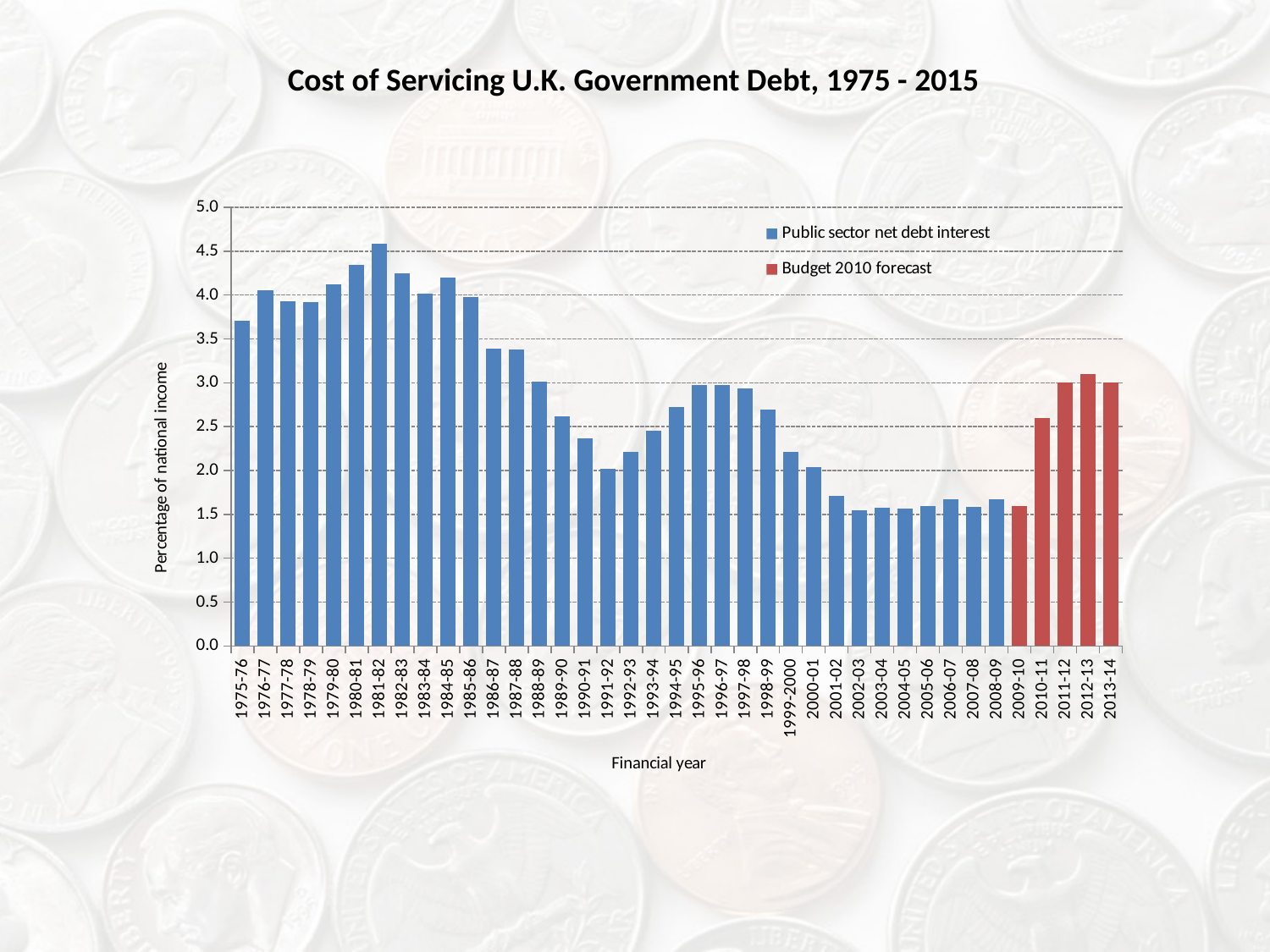
What kind of chart is shown on the slide? bar chart How many financial years are plotted on the x axis? 39 What is the title of the chart? Cost of Servicing U.K. Government Debt, 1975 - 2015 Is the value for 2012-13 greater or less than 3.0? greater Do the values generally rise or fall from 1981-82 to 1991-92? fall Is the value for 1975-76 greater or less than 3.5? greater How many series does the legend list? 2 Which financial year has the highest percentage of national income? 1981-82 Which is larger, the value for 1981-82 or the value for 1991-92? 1981-82 Is the value for 2009-10 greater or less than 2.0? less Which is larger, the value for 2010-11 or the value for 2012-13? 2012-13